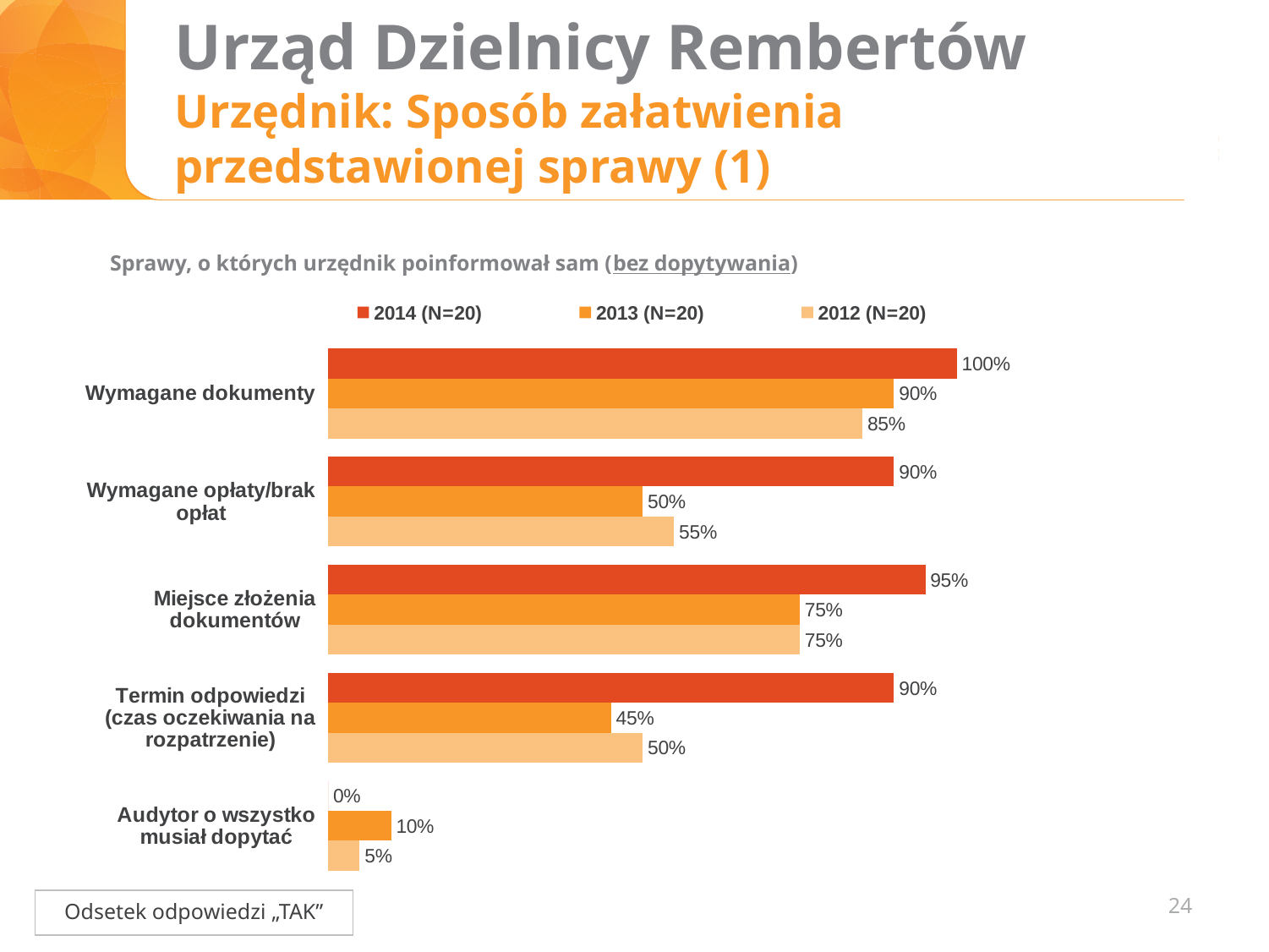
How many categories are shown on the chart? 5 What is the value for Wymagane dokumenty in the 2014 (N=20) series? 100% What is the value for Termin odpowiedzi (czas oczekiwania na rozpatrzenie) in the 2013 (N=20) series? 45% Which category has the lowest value in the 2013 (N=20) series? Audytor o wszystko musiał dopytać What is the value for Audytor o wszystko musiał dopytać in the 2012 (N=20) series? 5% Which is larger for Miejsce złożenia dokumentów: the 2014 (N=20) value or the 2013 (N=20) value? 2014 (N=20) What kind of chart is shown on the slide? Bar chart How many series does the legend list? 3 Which category has the highest value in the 2014 (N=20) series? Wymagane dokumenty What is the subtitle printed above the chart? Sprawy, o których urzędnik poinformował sam (bez dopytywania) What is the difference between the 2014 (N=20) and 2013 (N=20) values for Wymagane opłaty/brak opłat? 40% What is the value for Wymagane dokumenty in the 2012 (N=20) series? 85%